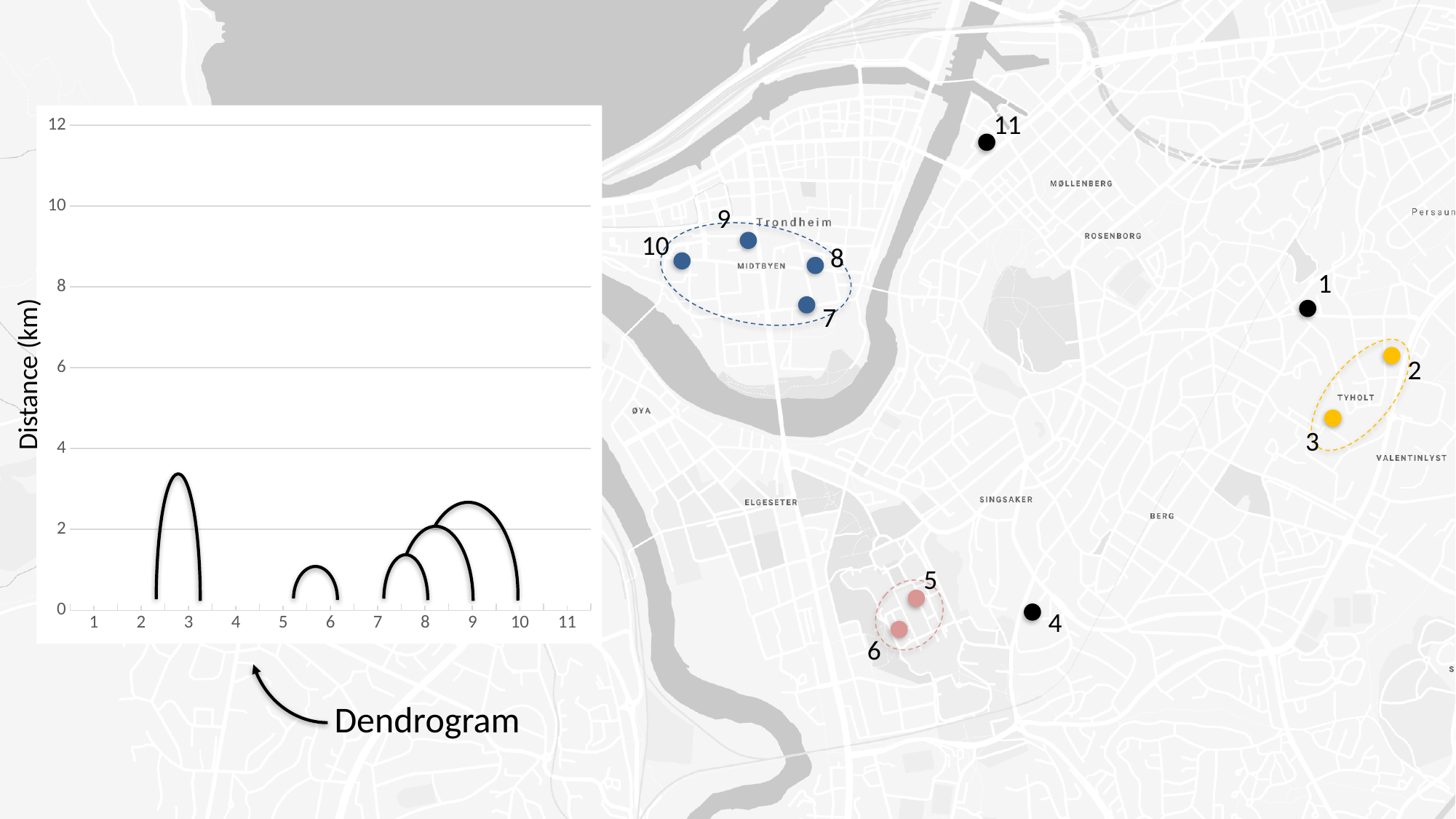
What kind of chart is shown on the left of the slide? Dendrogram What is the highest tick value shown on the vertical axis of the dendrogram? 12 What is the label of the vertical axis of the dendrogram? Distance (km) How many arcs are drawn in the dendrogram? 5 Is the height of the arc joining points 5 and 6 in the dendrogram greater or less than 2? less Is the height of the arc joining points 2 and 3 in the dendrogram greater or less than 2? greater Which pair of points is joined by the tallest arc in the dendrogram? 2 and 3 Is the height of the arc joining points 2 and 3 in the dendrogram greater or less than 4? less How many numbered points are labelled along the x axis of the dendrogram? 11 In the dendrogram, which arc is taller: the one joining points 7 and 8 or the outermost arc reaching point 10? the outermost arc reaching point 10 In the dendrogram, which arc is taller: the one joining points 2 and 3 or the one joining points 5 and 6? 2 and 3